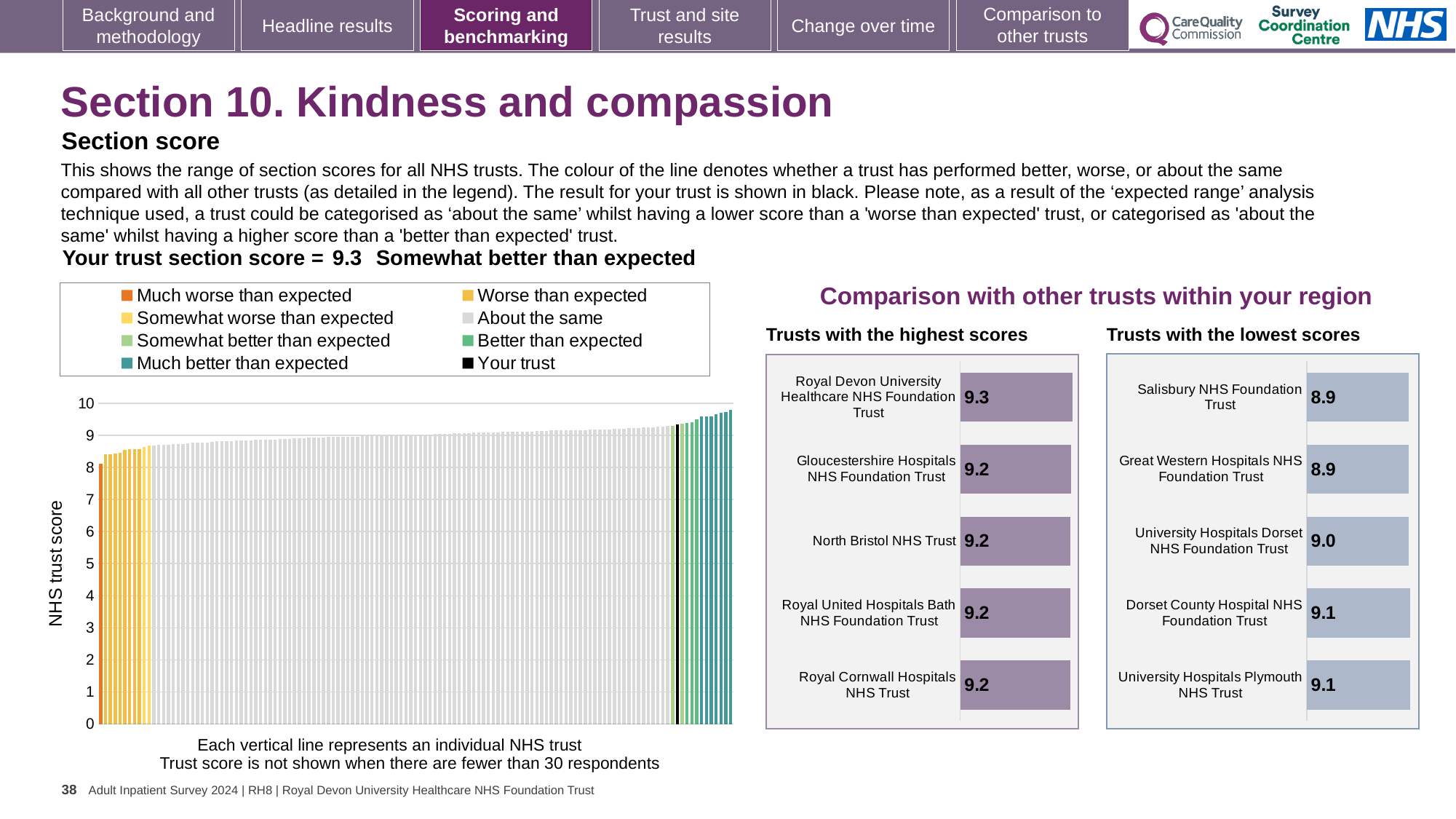
In the 'Trusts with the highest scores' chart, what is the score for North Bristol NHS Trust? 9.2 In the 'Trusts with the lowest scores' chart, which has the larger score: Dorset County Hospital NHS Foundation Trust or Great Western Hospitals NHS Foundation Trust? Dorset County Hospital NHS Foundation Trust In the 'Trusts with the lowest scores' chart, what is the difference between the scores of University Hospitals Plymouth NHS Trust and Salisbury NHS Foundation Trust? 0.2 In the 'Trusts with the lowest scores' chart, what is the score for University Hospitals Dorset NHS Foundation Trust? 9.0 In the 'Trusts with the lowest scores' chart, what is the score for Salisbury NHS Foundation Trust? 8.9 What kind of chart is the NHS trust score chart on the left of the slide? Bar chart In the 'Trusts with the highest scores' chart, which trust has the highest score? Royal Devon University Healthcare NHS Foundation Trust How many trusts are shown in the 'Trusts with the lowest scores' chart? 5 In the 'Trusts with the highest scores' chart, what is the score for Royal Devon University Healthcare NHS Foundation Trust? 9.3 In the NHS trust score chart on the left, do the values rise or fall from left to right? Rise How many entries does the legend of the NHS trust score chart on the left list? 8